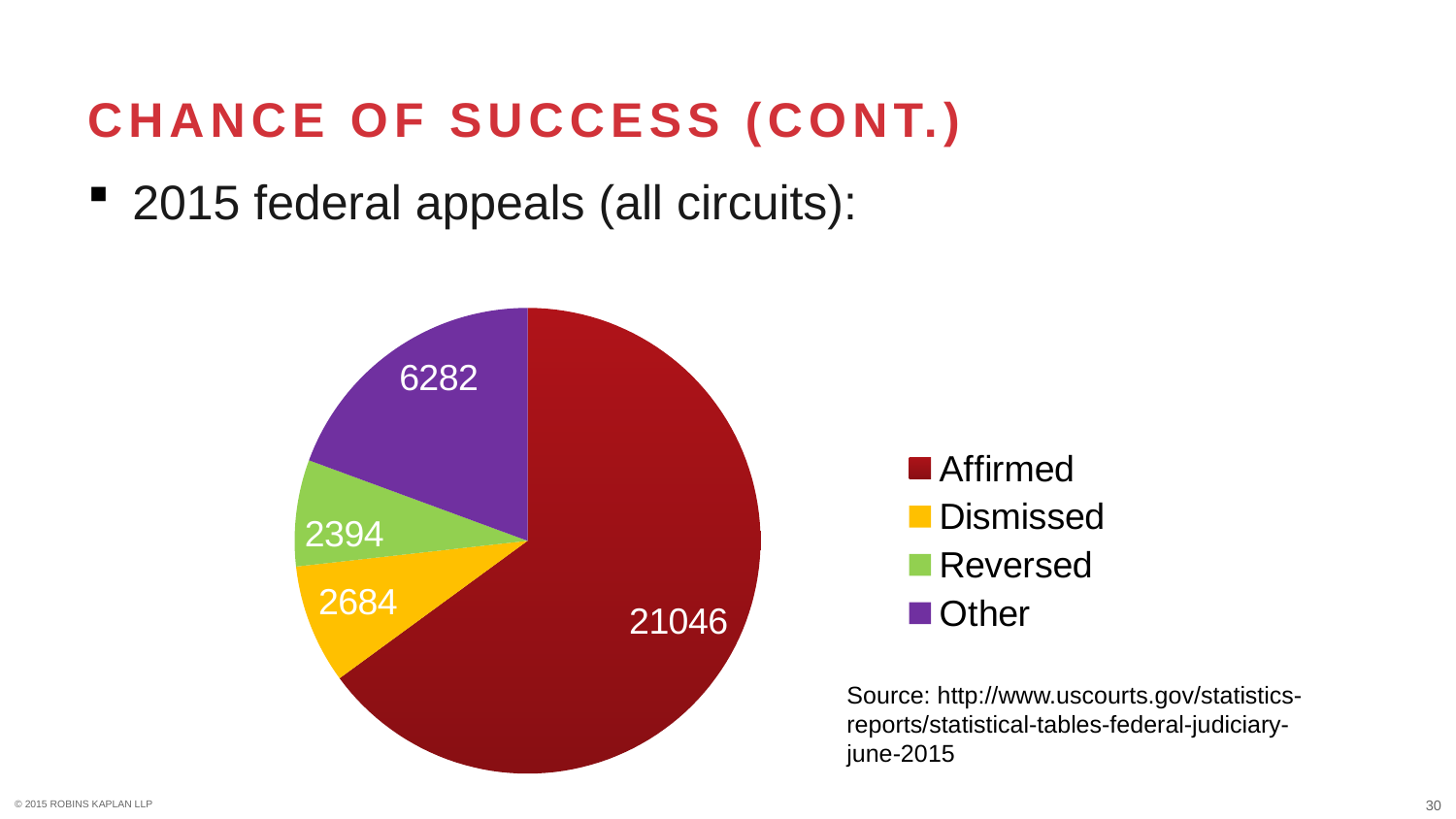
What is the value for Affirmed? 21046 What is the value for Dismissed? 2684 Which is larger, Dismissed or Reversed? Dismissed What is the value for Reversed? 2394 What is the value for Other? 6282 What colour is the Affirmed slice? Dark red Which category has the smallest slice? Reversed What type of chart is shown on the slide? Pie chart How many slices does the pie chart have? 4 How many entries does the legend list? 4 What is the difference between the Affirmed and Other values? 14764 Which category has the largest slice? Affirmed